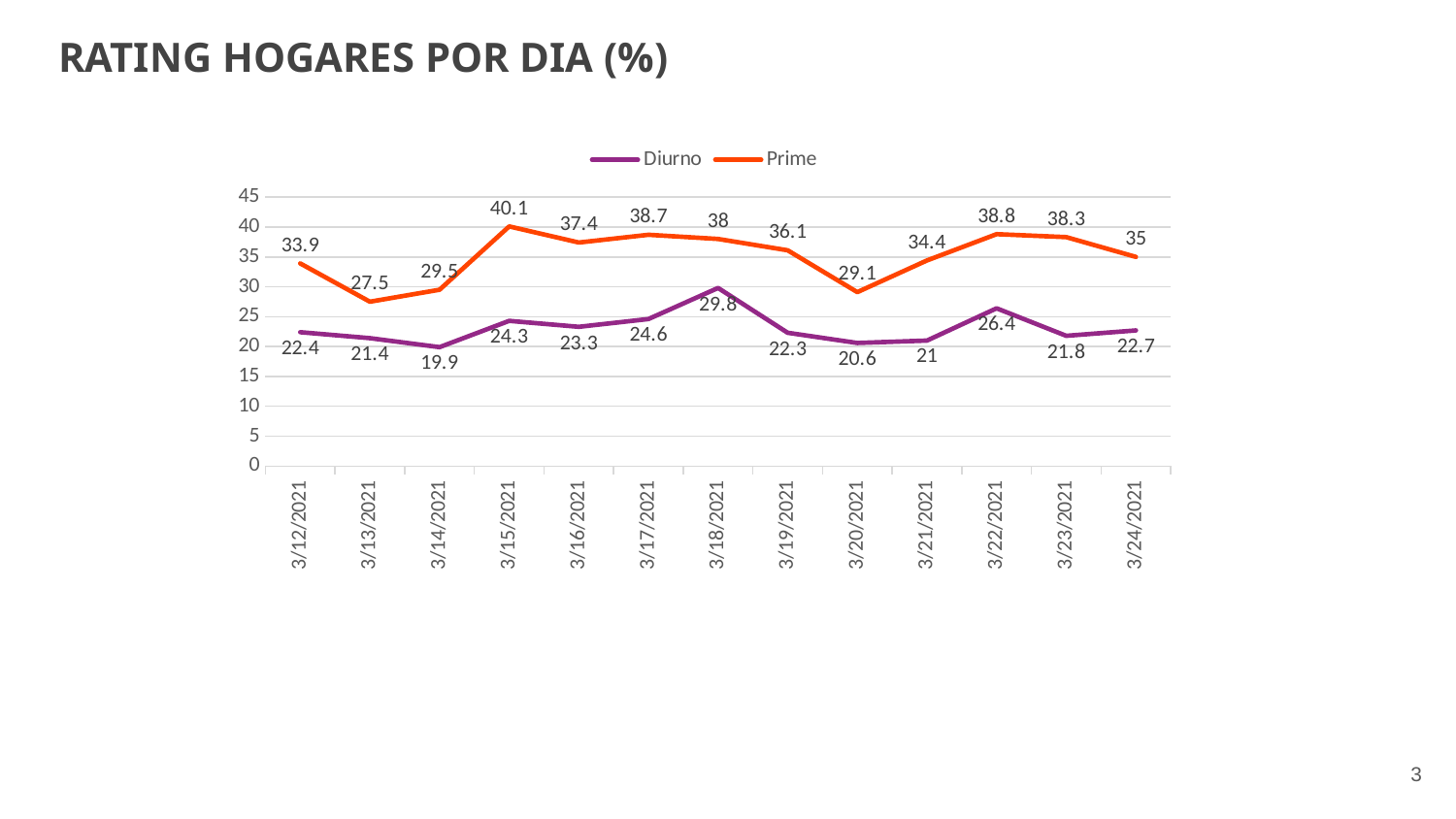
What is the Prime value on 3/15/2021? 40.1 What is the Prime value on 3/24/2021? 35 How many series does the legend list? 2 How many dates are plotted along the x axis? 13 On which date does the Diurno series reach its highest value? 3/18/2021 What type of chart is shown on the slide? Line chart Which series has the higher value on 3/20/2021, Diurno or Prime? Prime Does the Prime series rise or fall from 3/22/2021 to 3/24/2021? Fall What is the difference between the Prime and Diurno values on 3/15/2021? 15.8 What is the Diurno value on 3/14/2021? 19.9 What colour is the line for the Prime series? Orange On which date does the Prime series have its lowest value? 3/13/2021